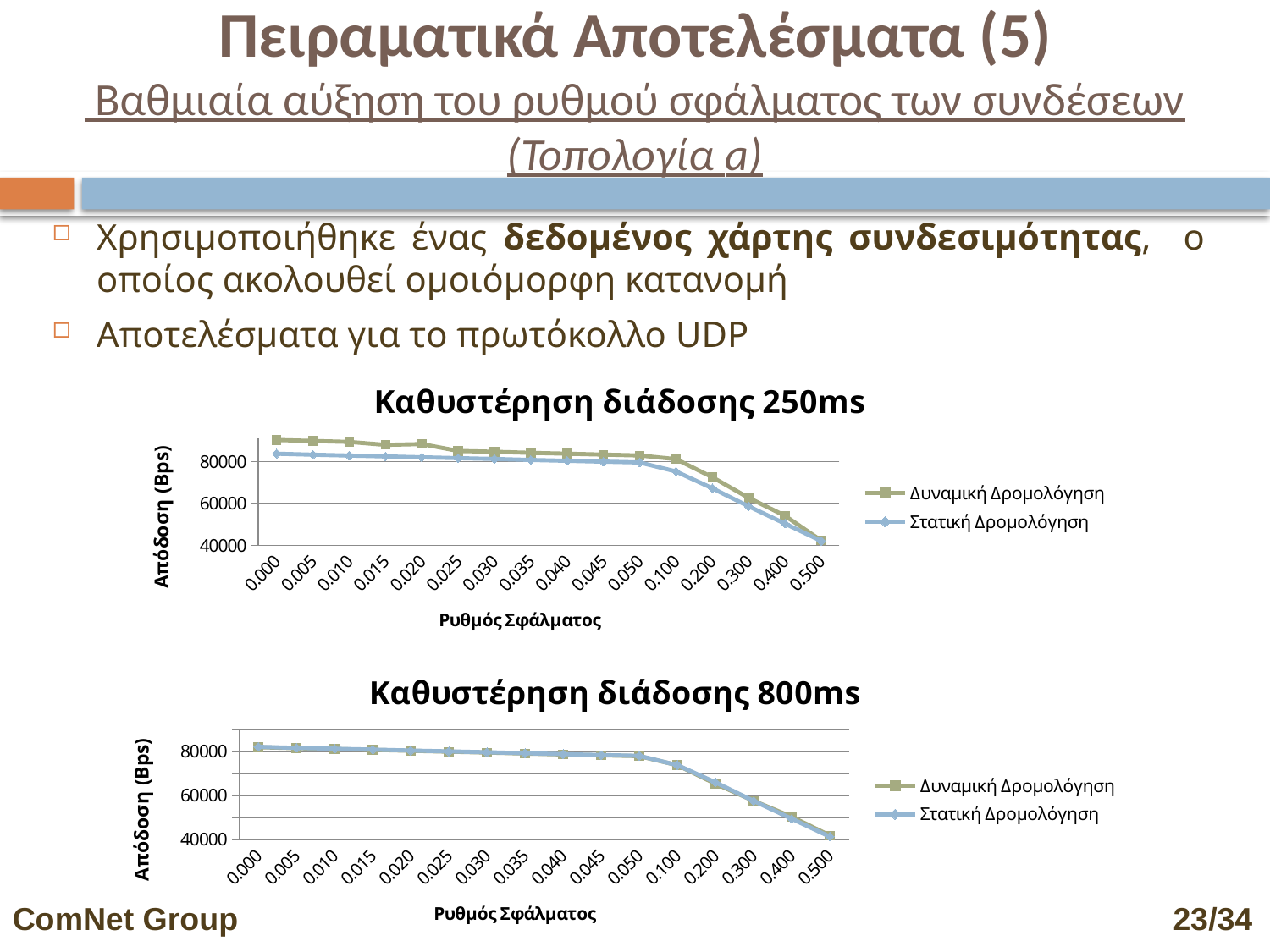
What is the label of the y axis on the chart titled "Καθυστέρηση διάδοσης 800ms"? Απόδοση (Bps) In the chart titled "Καθυστέρηση διάδοσης 250ms", which series has the higher value at error rate 0.000, Δυναμική Δρομολόγηση or Στατική Δρομολόγηση? Δυναμική Δρομολόγηση In the chart titled "Καθυστέρηση διάδοσης 800ms", does the Στατική Δρομολόγηση series rise or fall as the error rate increases along the x axis? fall How many series does the legend of the chart titled "Καθυστέρηση διάδοσης 800ms" list? 2 How many error-rate categories are shown on the x axis of the chart titled "Καθυστέρηση διάδοσης 250ms"? 16 What kind of chart is the chart titled "Καθυστέρηση διάδοσης 250ms"? line chart In the chart titled "Καθυστέρηση διάδοσης 250ms", does the Δυναμική Δρομολόγηση series rise or fall as the error rate increases along the x axis? fall In the chart titled "Καθυστέρηση διάδοσης 250ms", is the value for Δυναμική Δρομολόγηση at error rate 0.000 greater or less than 80000? greater In the chart titled "Καθυστέρηση διάδοσης 250ms", is the value for Δυναμική Δρομολόγηση at error rate 0.200 greater or less than 80000? less In the chart titled "Καθυστέρηση διάδοσης 800ms", is the value for Στατική Δρομολόγηση at error rate 0.400 greater or less than 40000? greater In the chart titled "Καθυστέρηση διάδοσης 250ms", at which error rate is the Δυναμική Δρομολόγηση value lowest? 0.500